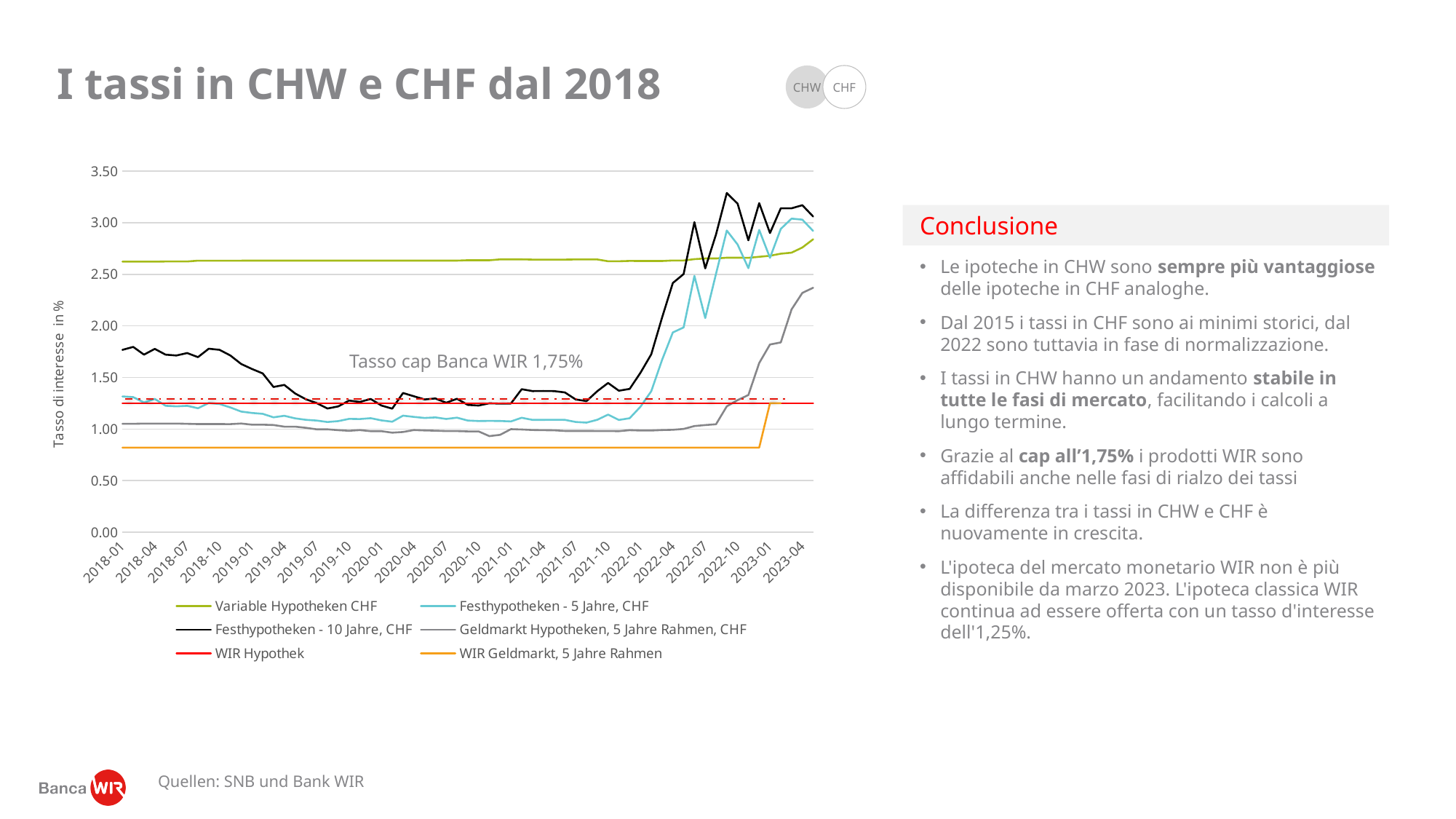
What kind of chart is shown on the slide? line chart Is the value for Festhypotheken - 10 Jahre, CHF at 2018-01 greater or less than 1.50? greater Is the value for Geldmarkt Hypotheken, 5 Jahre Rahmen, CHF at 2023-04 greater or less than 2.00? greater What is the title of the slide containing the chart? I tassi in CHW e CHF dal 2018 Is the value for WIR Geldmarkt, 5 Jahre Rahmen at 2018-01 greater or less than 1.00? less At 2023-04, which is higher: Festhypotheken - 10 Jahre, CHF or WIR Hypothek? Festhypotheken - 10 Jahre, CHF At 2018-01, which is higher: Variable Hypotheken CHF or Festhypotheken - 10 Jahre, CHF? Variable Hypotheken CHF How many series does the chart legend list? 6 Does the Festhypotheken - 10 Jahre, CHF line rise or fall between 2022-01 and 2022-07? rise What rate does the annotation on the chart give for the Banca WIR cap? 1,75%